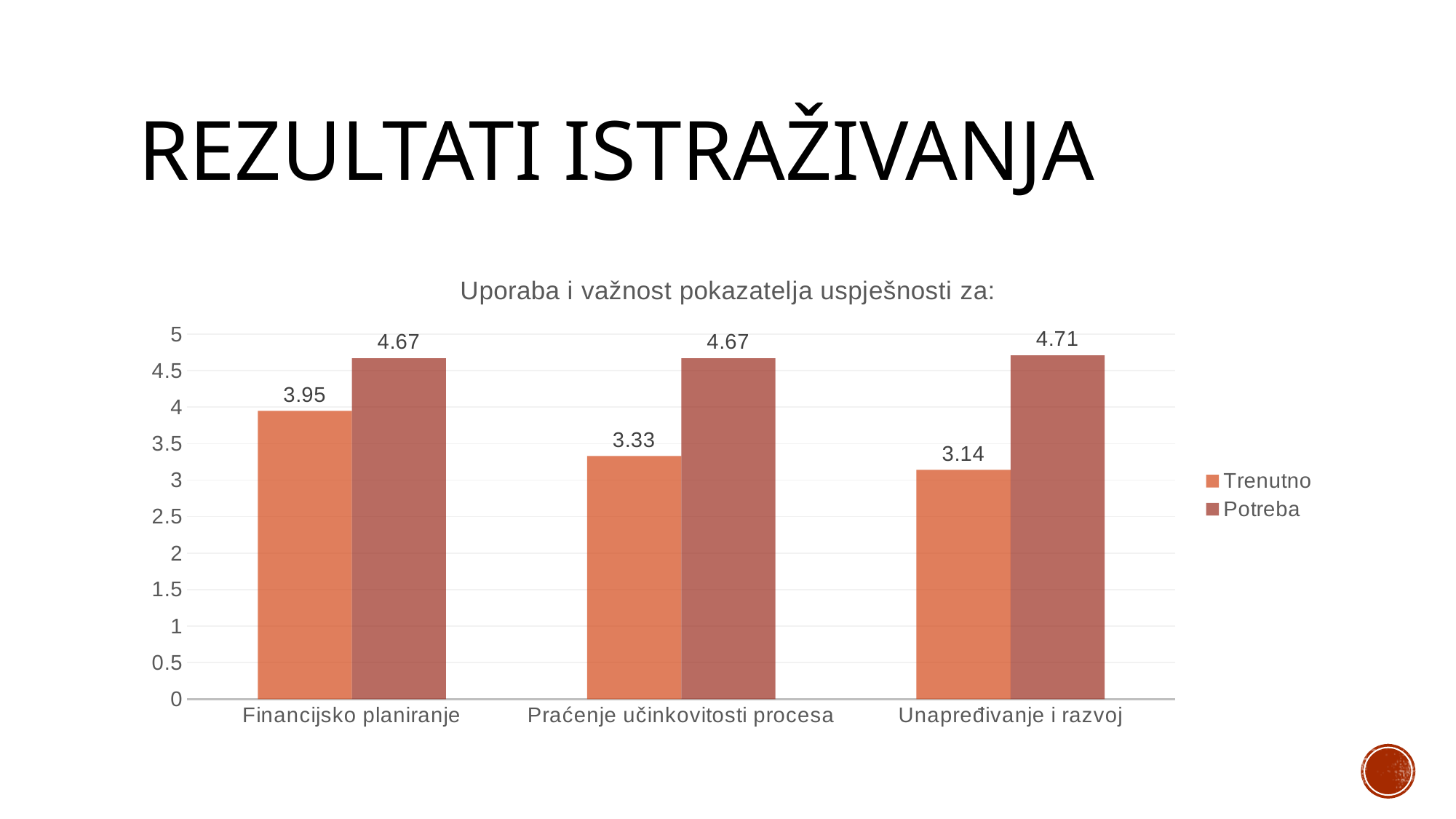
What is the Potreba value for Unapređivanje i razvoj? 4.71 What kind of chart is shown on the slide? bar chart What is the difference between the Potreba and Trenutno values for Unapređivanje i razvoj? 1.57 Which category has the highest Potreba value? Unapređivanje i razvoj What is the Trenutno value for Financijsko planiranje? 3.95 What is the Trenutno value for Praćenje učinkovitosti procesa? 3.33 Which category has the lowest Trenutno value? Unapređivanje i razvoj Is the Trenutno value for Praćenje učinkovitosti procesa greater or less than 3.5? less What is the difference between the Trenutno values for Financijsko planiranje and Praćenje učinkovitosti procesa? 0.62 How many series does the legend list? 2 Which is larger: the Trenutno value for Financijsko planiranje or the Trenutno value for Unapređivanje i razvoj? Financijsko planiranje How many categories are shown on the x axis? 3